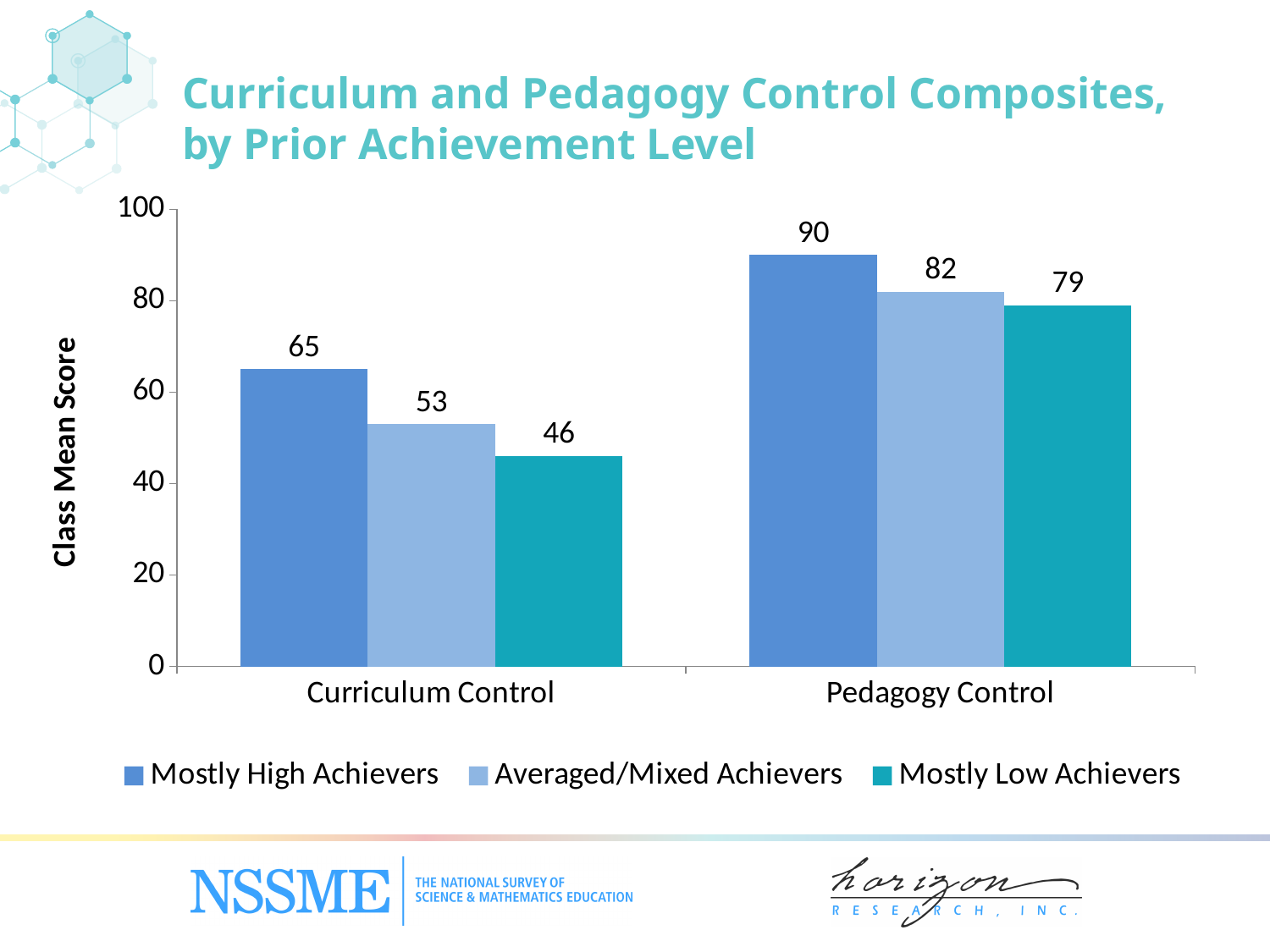
Which achievement level has the highest Class Mean Score for Pedagogy Control? Mostly High Achievers How many categories are shown on the x axis? 2 What is the difference between the Pedagogy Control and Curriculum Control scores for Averaged/Mixed Achievers? 29 How many series does the legend list? 3 Which is larger: the Mostly Low Achievers score for Pedagogy Control or the Mostly High Achievers score for Curriculum Control? Mostly Low Achievers score for Pedagogy Control What is the Class Mean Score for Mostly Low Achievers on Pedagogy Control? 79 What is the label of the y axis? Class Mean Score What kind of chart is shown on the slide? Bar chart What is the Class Mean Score for Mostly High Achievers on Curriculum Control? 65 What is the difference between the Mostly High Achievers and Mostly Low Achievers scores for Curriculum Control? 19 Which achievement level has the lowest Class Mean Score for Curriculum Control? Mostly Low Achievers What is the Class Mean Score for Averaged/Mixed Achievers on Curriculum Control? 53